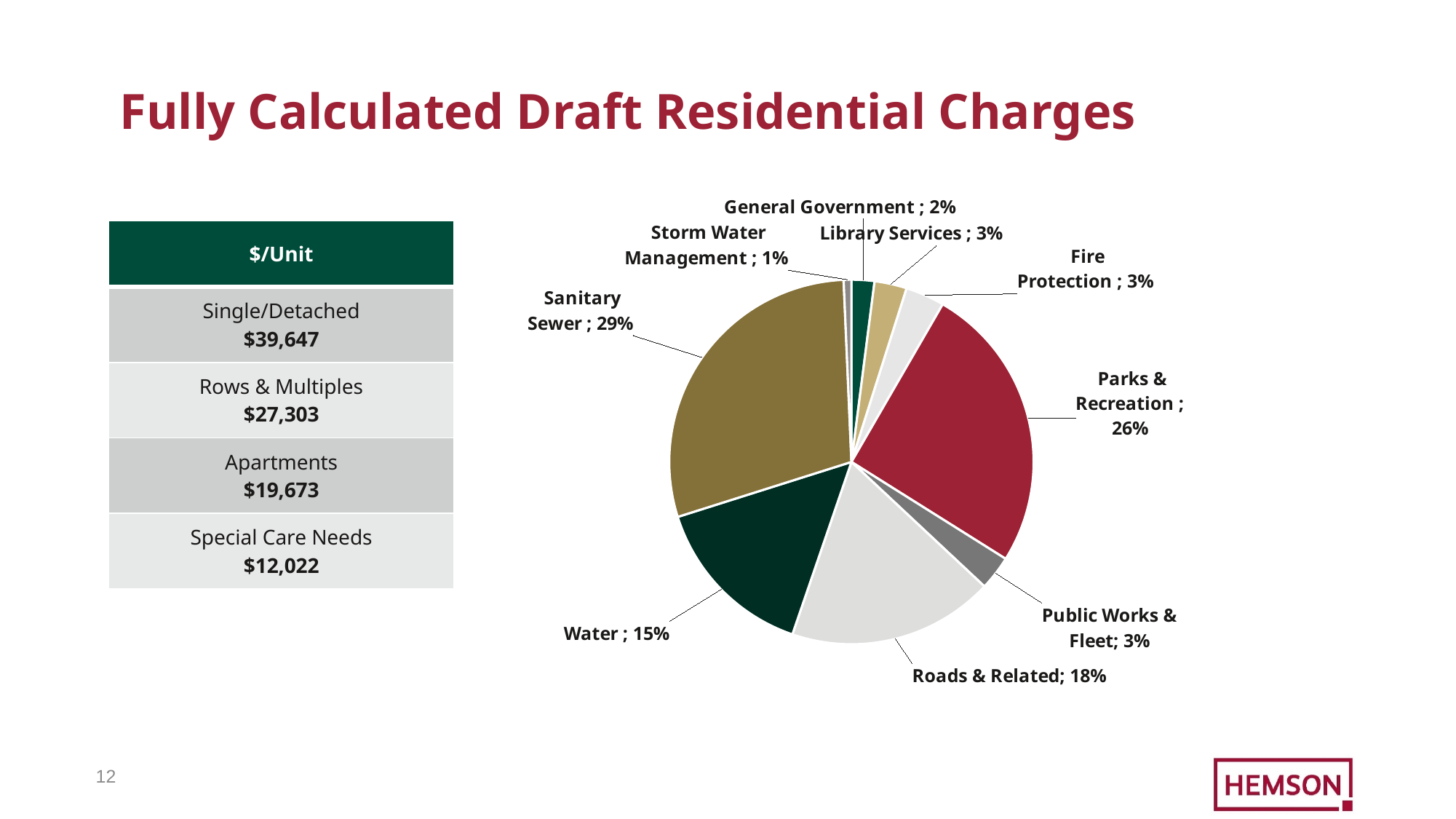
What is the value shown for Roads & Related? 18% Which is larger, Roads & Related or Water? Roads & Related What is the value shown for General Government? 2% Which category has the smallest slice of the pie? Storm Water Management What kind of chart is shown on the slide? pie chart What share of the pie does Sanitary Sewer account for? 29% What is the value shown for Water? 15% What is the value shown for Parks & Recreation? 26% How many categories are shown in the pie chart? 9 What is the value shown for Storm Water Management? 1% Which category has the largest slice of the pie? Sanitary Sewer What is the difference in percentage points between Sanitary Sewer and Parks & Recreation? 3